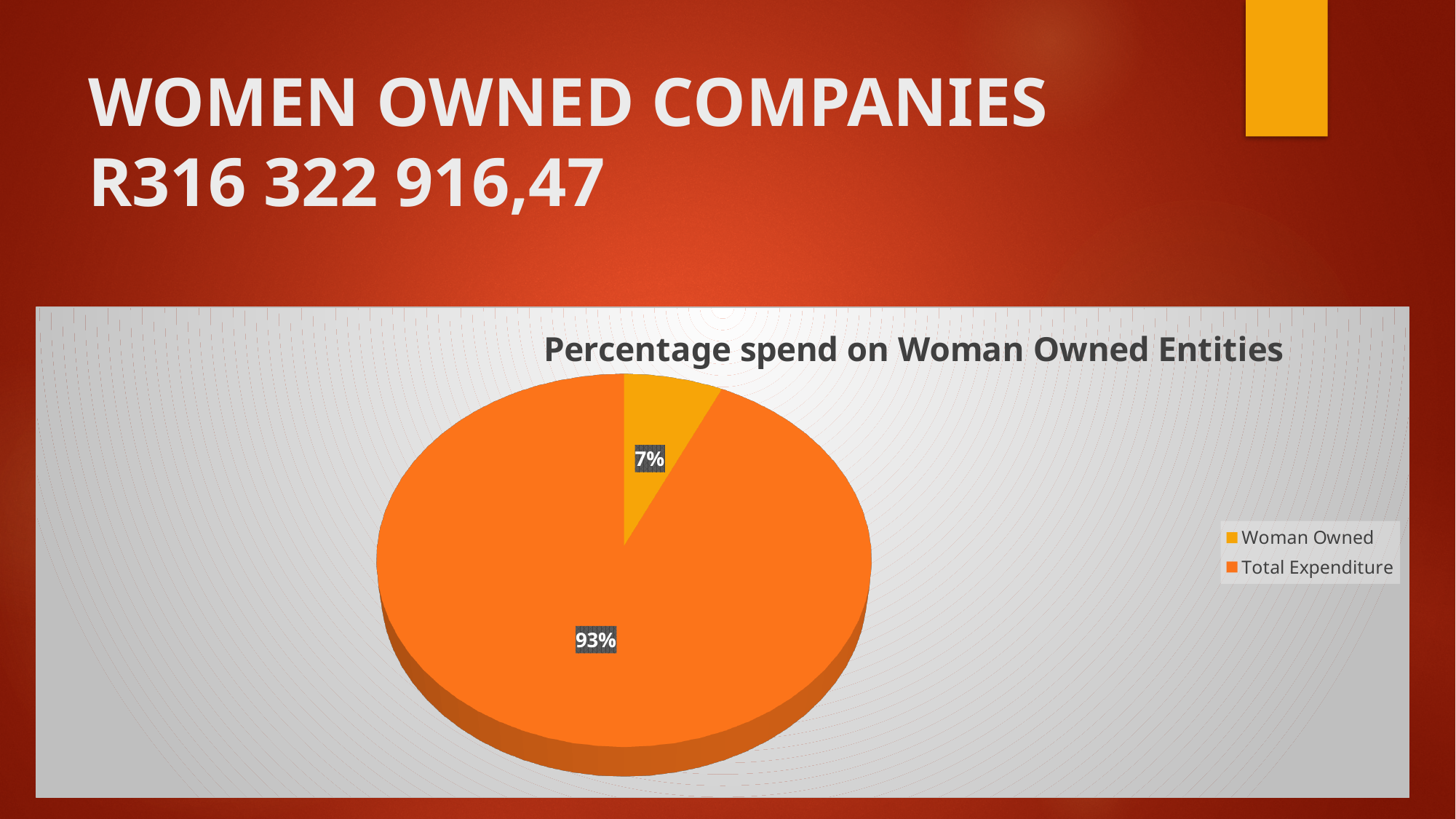
What share of the pie does the Woman Owned slice represent? 7% What type of chart is shown on the slide? pie chart What is the difference in percentage points between Total Expenditure and Woman Owned? 86 What percentage is shown for Total Expenditure? 93% What is the title of the chart? Percentage spend on Woman Owned Entities What colour is the Woman Owned slice in the legend? yellow Which is larger, the Woman Owned slice or the Total Expenditure slice? Total Expenditure Which slice of the pie is the largest? Total Expenditure How many entries does the legend list? 2 What percentage is shown for Woman Owned? 7% Which slice of the pie is the smallest? Woman Owned How many slices does the pie chart have? 2